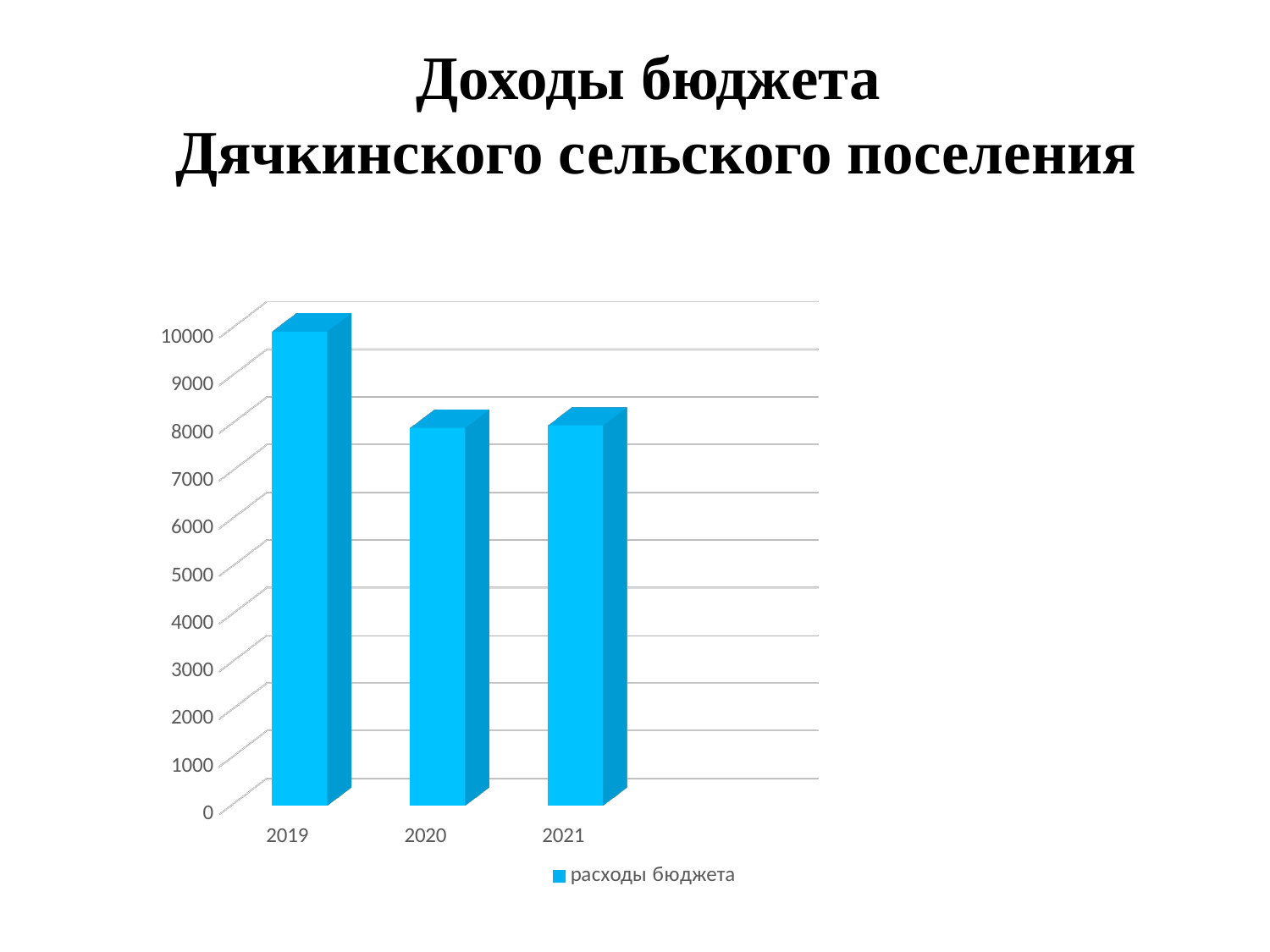
Which is larger, the value for 2019 or the value for 2020? 2019 Is the value for 2020 greater or less than 9000? less Is the value for 2021 greater or less than 7000? greater How many series does the chart legend list? 1 What kind of chart is shown on the slide? bar chart Is the value for 2021 greater or less than 9000? less What is the name of the series shown in the chart legend? расходы бюджета Which year has the highest bar in the chart? 2019 How many years are shown on the x axis of the chart? 3 What is the title of the slide containing the chart? Доходы бюджета Дячкинского сельского поселения